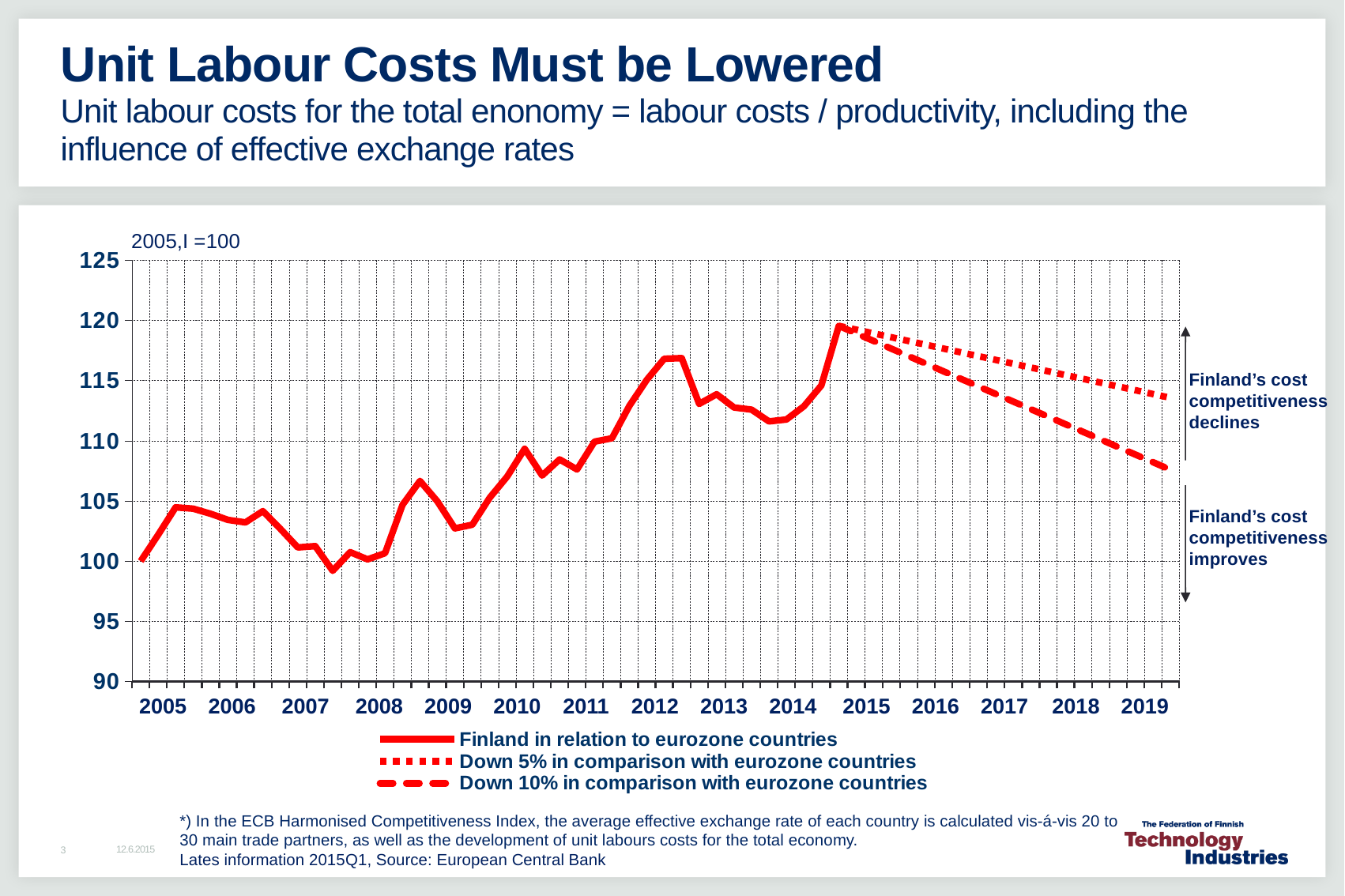
Is the value of the 'Down 10% in comparison with eurozone countries' line in 2019 greater or less than 110? less How many series does the chart legend list? 3 Is the peak value of the 'Finland in relation to eurozone countries' line in 2012 greater or less than 115? greater Does the 'Finland in relation to eurozone countries' line rise or fall between 2009 and 2012? rise In 2019, which line is higher: 'Down 5% in comparison with eurozone countries' or 'Down 10% in comparison with eurozone countries'? Down 5% in comparison with eurozone countries What type of chart is shown on the slide? line chart Do the two projection lines rise or fall from 2015 to 2019? fall Is the lowest value of the 'Finland in relation to eurozone countries' line in 2007 greater or less than 100? less In which year does the 'Finland in relation to eurozone countries' line reach its highest value? 2015 How many year labels are shown on the x axis? 15 What is the index value of the solid line at the start of 2005? 100